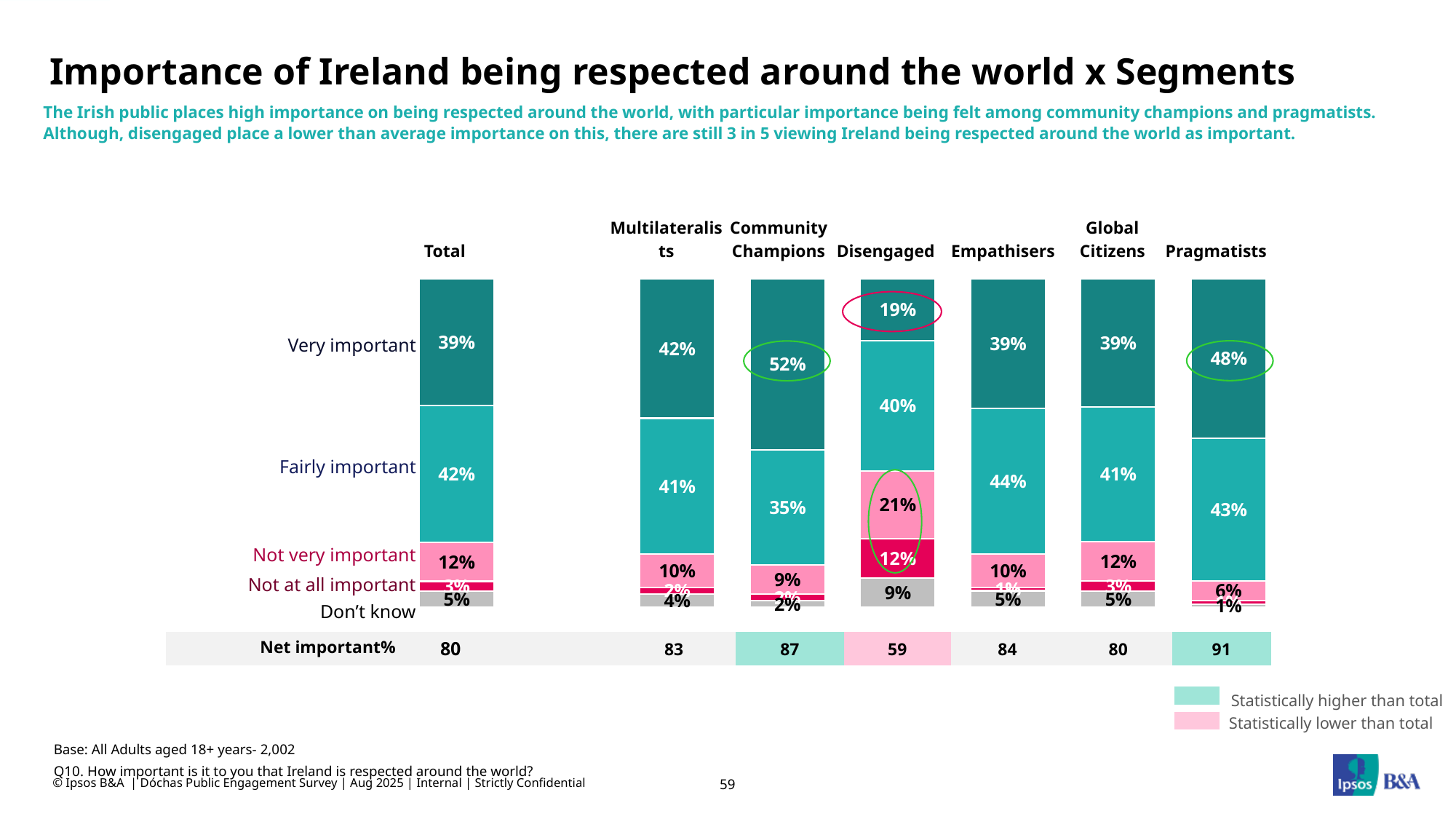
How many response categories are listed down the left side of the chart? 5 What percentage of Community Champions say Ireland being respected around the world is very important? 52% What is the difference between the 'Very important' percentage for Pragmatists and for Total? 9% What is the Net important% for Pragmatists? 91 Which segment has the lowest Net important%? Disengaged Which segment has the highest 'Very important' percentage? Community Champions Which is larger: the 'Not very important' share for Disengaged or for Global Citizens? Disengaged What does the light green shading in the Net important% row indicate? Statistically higher than total What is the 'Don't know' percentage for the Disengaged segment? 9% What is the 'Fairly important' value for the Disengaged segment? 40% How many segment columns (including Total) are shown in the chart? 7 What type of chart is shown on the slide? Stacked bar chart